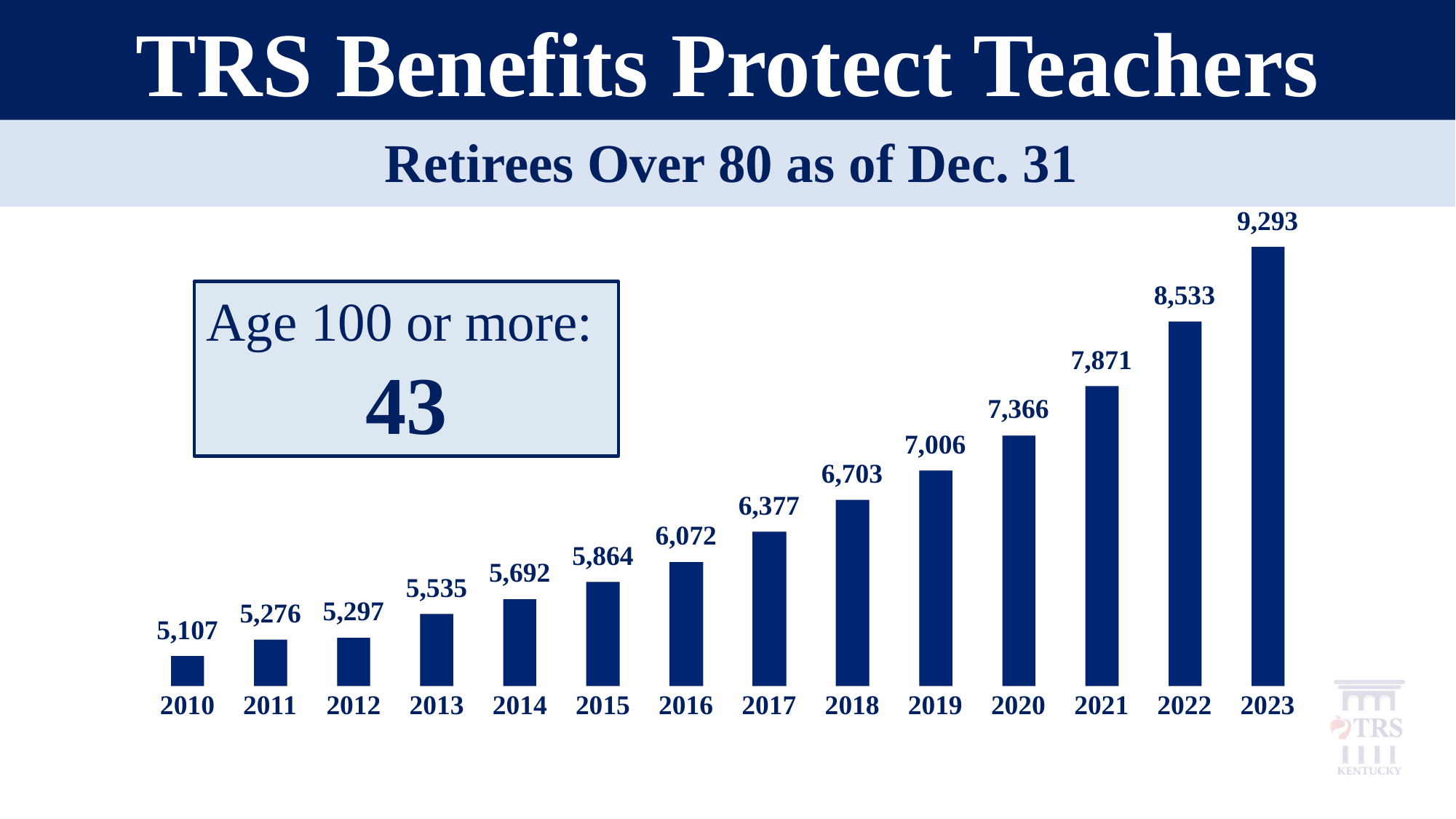
What is the number of retirees over 80 in 2010? 5,107 Which year has the highest number of retirees over 80? 2023 What is the difference between the number of retirees over 80 in 2023 and in 2022? 760 Which year has the lowest number of retirees over 80? 2010 What is the number of retirees over 80 in 2017? 6,377 What is the difference between the number of retirees over 80 in 2020 and in 2010? 2,259 According to the box on the slide, how many retirees are age 100 or more? 43 What is the number of retirees over 80 in 2023? 9,293 Do the values rise or fall from 2010 to 2023? Rise How many years are shown on the chart? 14 Which year has more retirees over 80, 2015 or 2019? 2019 What kind of chart is shown on the slide? Bar chart